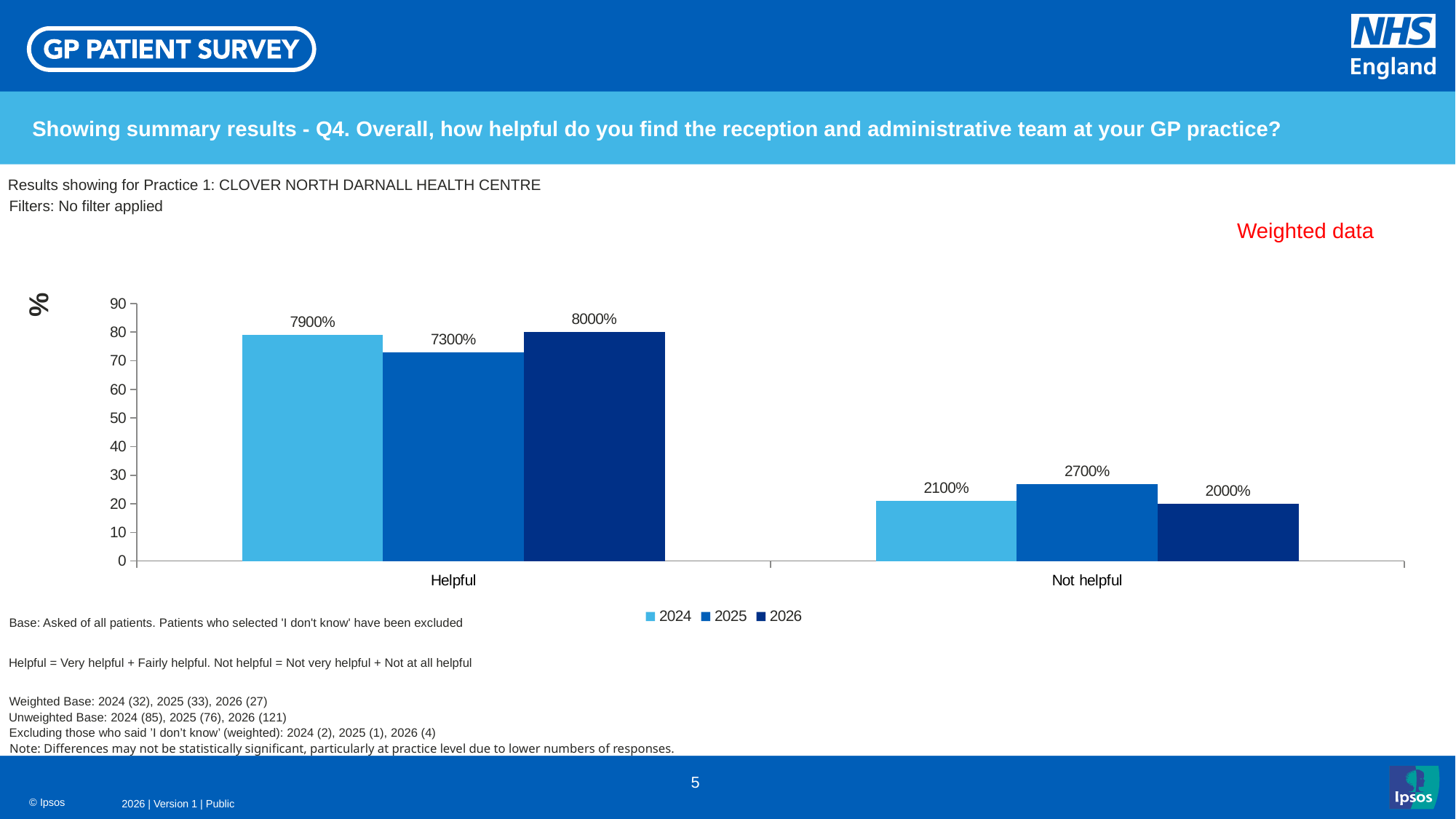
Which is larger in the Helpful category, the 2024 bar or the 2025 bar? 2024 What is the data label shown for 2024 in the Helpful category? 7900% Which year has the highest bar in the Helpful category? 2026 What is the data label shown for 2026 in the Not helpful category? 2000% What is the data label shown for 2025 in the Not helpful category? 2700% What kind of chart is shown on the slide? bar chart Is the 2025 bar for Not helpful greater or less than 30 on the axis? less How many categories are shown on the x axis? 2 How many series does the legend list? 3 What is the data label shown for 2025 in the Helpful category? 7300% Which year has the lowest bar in the Not helpful category? 2026 What are the legend entries for the chart? 2024, 2025, 2026